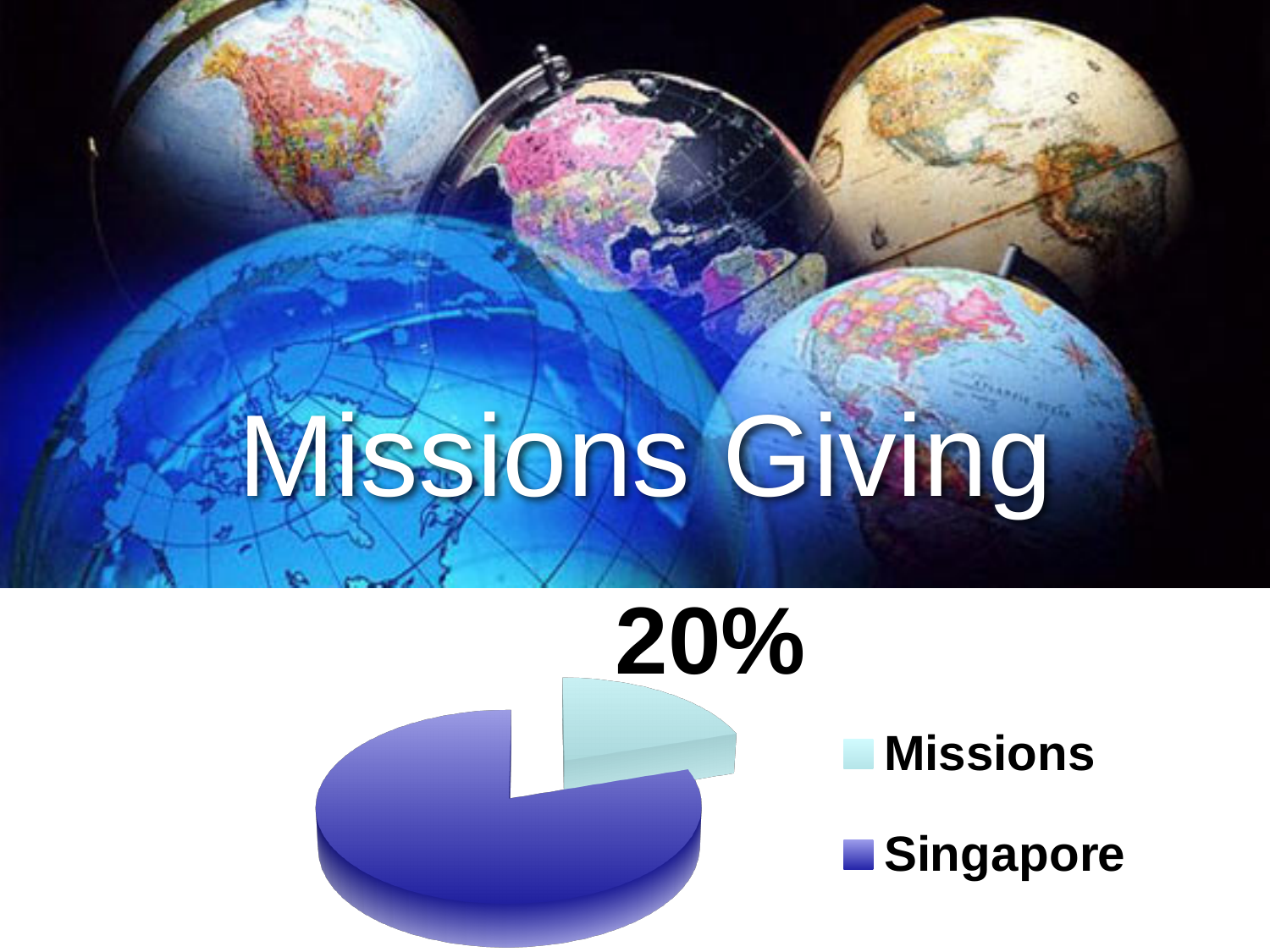
What kind of chart is shown on the slide? Pie chart Which legend entry is shown in the light blue colour? Missions Which category has the smallest slice of the pie chart? Missions What is the title shown on the slide above the chart? Missions Giving Which category has the largest slice of the pie chart? Singapore What share of the pie does the Missions slice represent? 20% Which slice is larger, Missions or Singapore? Singapore How many entries does the chart legend list? 2 What percentage of the pie chart is labelled for Missions? 20% How many categories are shown in the pie chart? 2